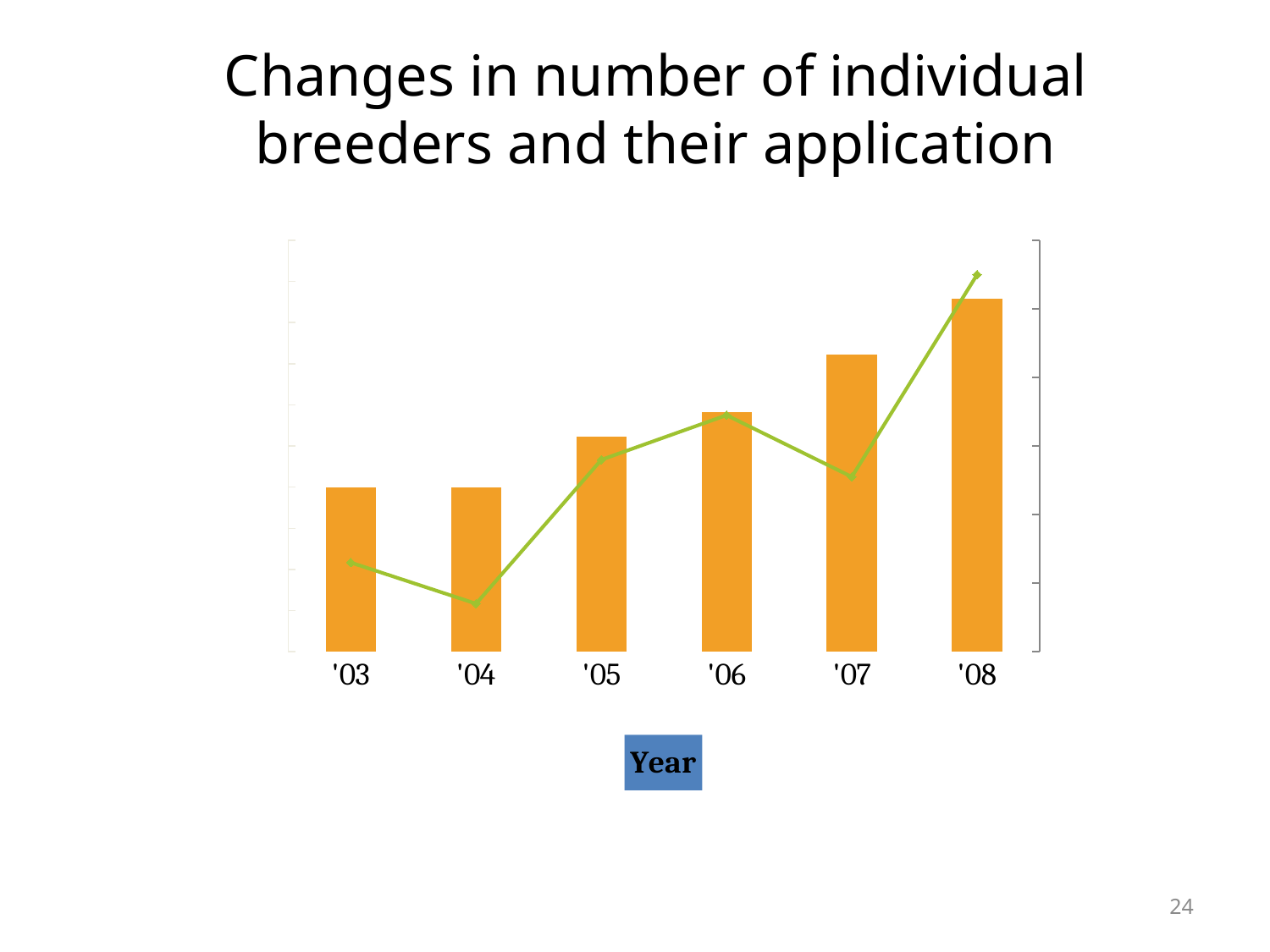
Is the orange bar for '07 taller or shorter than the orange bar for '06? Taller In which year does the green line reach its highest point? '08 What is the title of the chart on the slide? Changes in number of individual breeders and their application What kind of chart is shown on the slide? A combined bar and line chart In which year does the green line reach its lowest point? '04 Is the orange bar for '05 taller or shorter than the orange bar for '04? Taller Which year has the tallest orange bar? '08 Does the green line rise or fall between '06 and '07? Fall How many years are shown on the x axis of the chart? 6 What label is shown below the x axis of the chart? Year Do the orange bars generally rise or fall from '03 to '08? Rise Is the green line higher at '06 or at '07? '06